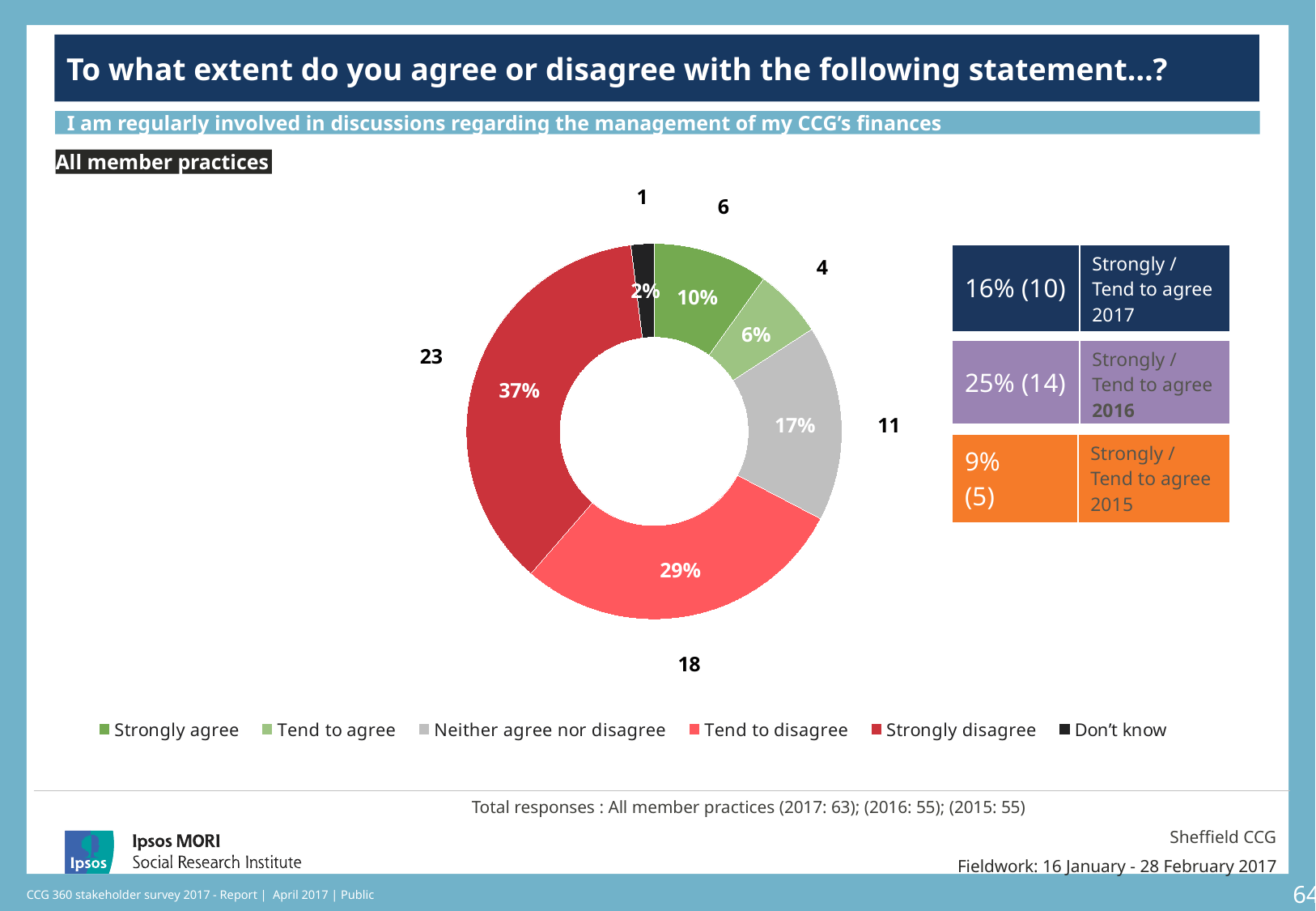
What percentage of respondents said 'Don't know'? 2% What colour is used for the 'Strongly disagree' segment? Dark red How many response categories does the legend list? 6 What kind of chart is shown on the slide? Donut (pie) chart What percentage of respondents said 'Strongly disagree'? 37% What is the combined percentage for 'Strongly agree' and 'Tend to agree' in 2017, as shown in the box to the right of the chart? 16% (10) Which response category has the largest share of the chart? Strongly disagree What is the difference in percentage points between 'Strongly disagree' and 'Tend to disagree'? 8 What percentage of respondents said 'Neither agree nor disagree'? 17% Which is larger, the share for 'Strongly agree' or the share for 'Tend to agree'? Strongly agree Which response category has the smallest share of the chart? Don't know How many respondents said 'Tend to disagree'? 18